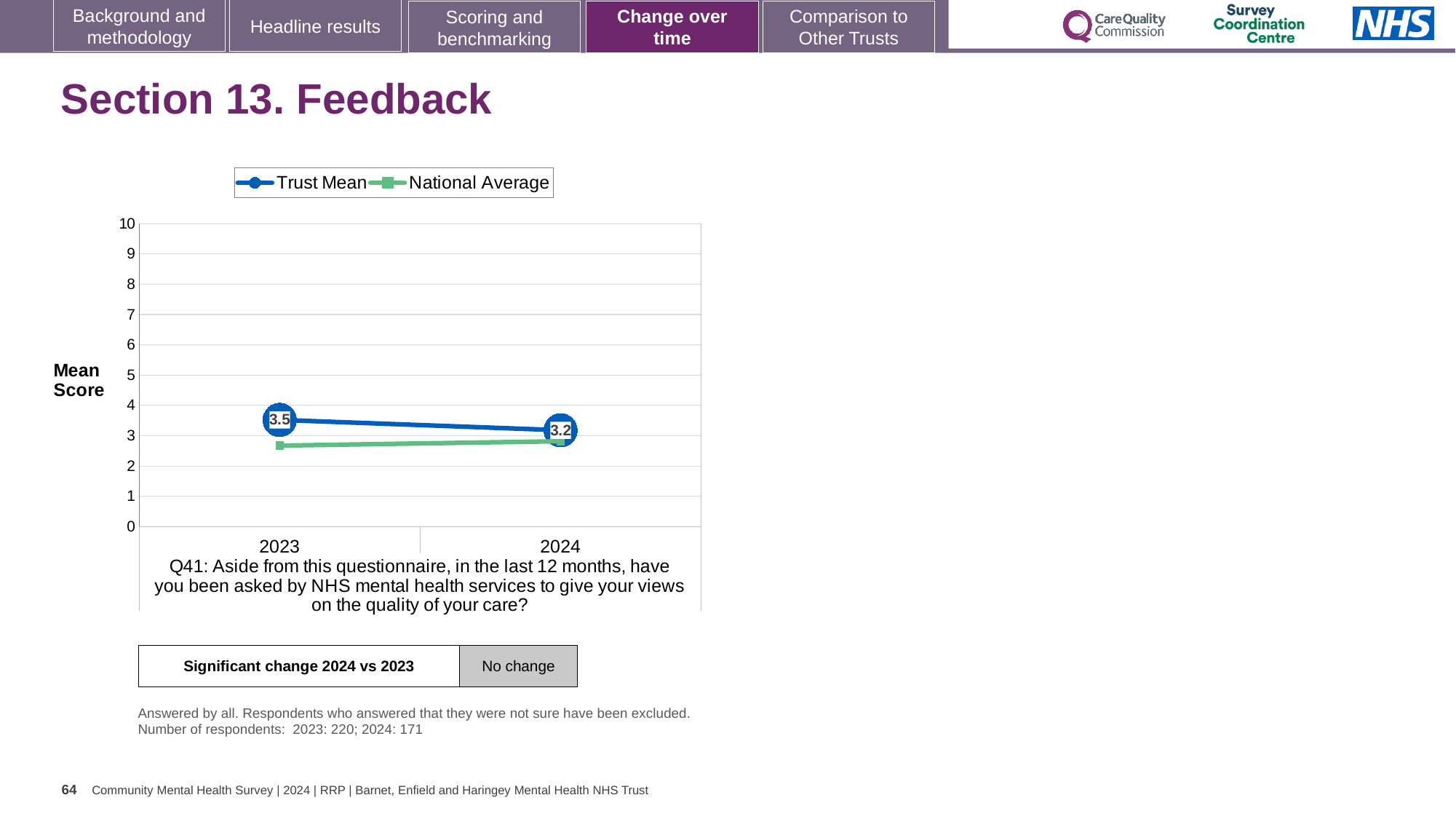
Is the Trust Mean value for 2024 greater or less than 3? greater How many series does the chart legend list? 2 In which year is the Trust Mean score higher? 2023 How many years are shown on the x axis of the chart? 2 What is the Trust Mean score for 2023? 3.5 Is the National Average value for 2023 greater or less than 3? less By how much did the Trust Mean score change from 2023 to 2024? 0.3 Does the Trust Mean rise or fall from 2023 to 2024? fall What kind of chart is shown on the slide? line chart What is the Trust Mean score for 2024? 3.2 In which year is the Trust Mean score lower? 2024 Is the Trust Mean for 2023 larger or smaller than the Trust Mean for 2024? larger